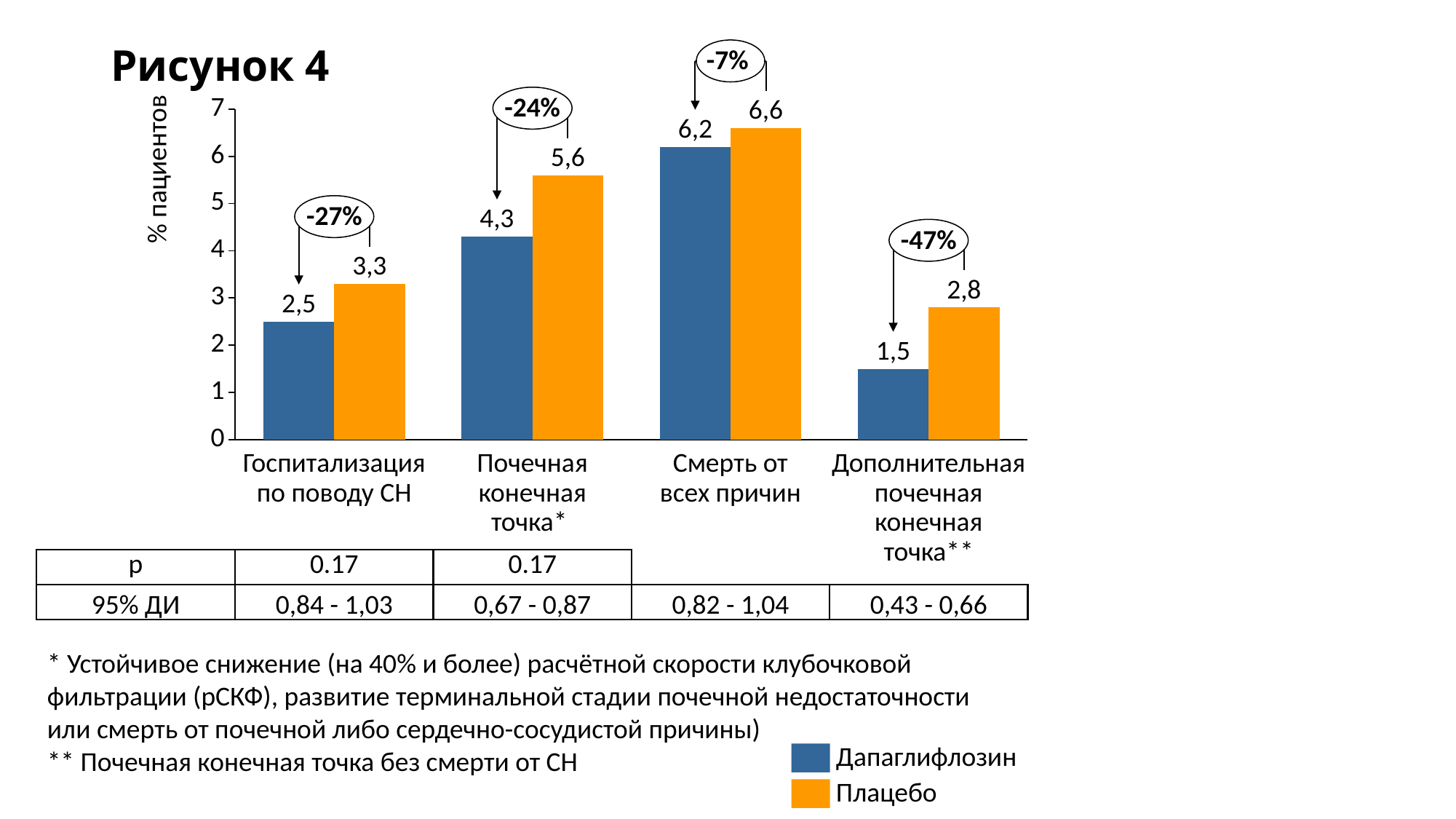
What is the value for Дапаглифлозин in the Смерть от всех причин category? 6,2 What is the value for Плацебо in the Дополнительная почечная конечная точка** category? 2,8 How many series does the legend list? 2 Which category has the lowest value for Дапаглифлозин? Дополнительная почечная конечная точка** How many categories are shown on the x axis? 4 Which is larger in the Госпитализация по поводу СН category: Дапаглифлозин or Плацебо? Плацебо What kind of chart is shown on the slide? Bar chart What is the value for Плацебо in the Почечная конечная точка* category? 5,6 What is the value for Дапаглифлозин in the Госпитализация по поводу СН category? 2,5 What relative reduction is shown above the Смерть от всех причин category? -7% Which category has the highest value for Плацебо? Смерть от всех причин What is the difference between the Плацебо and Дапаглифлозин values in the Почечная конечная точка* category? 1,3